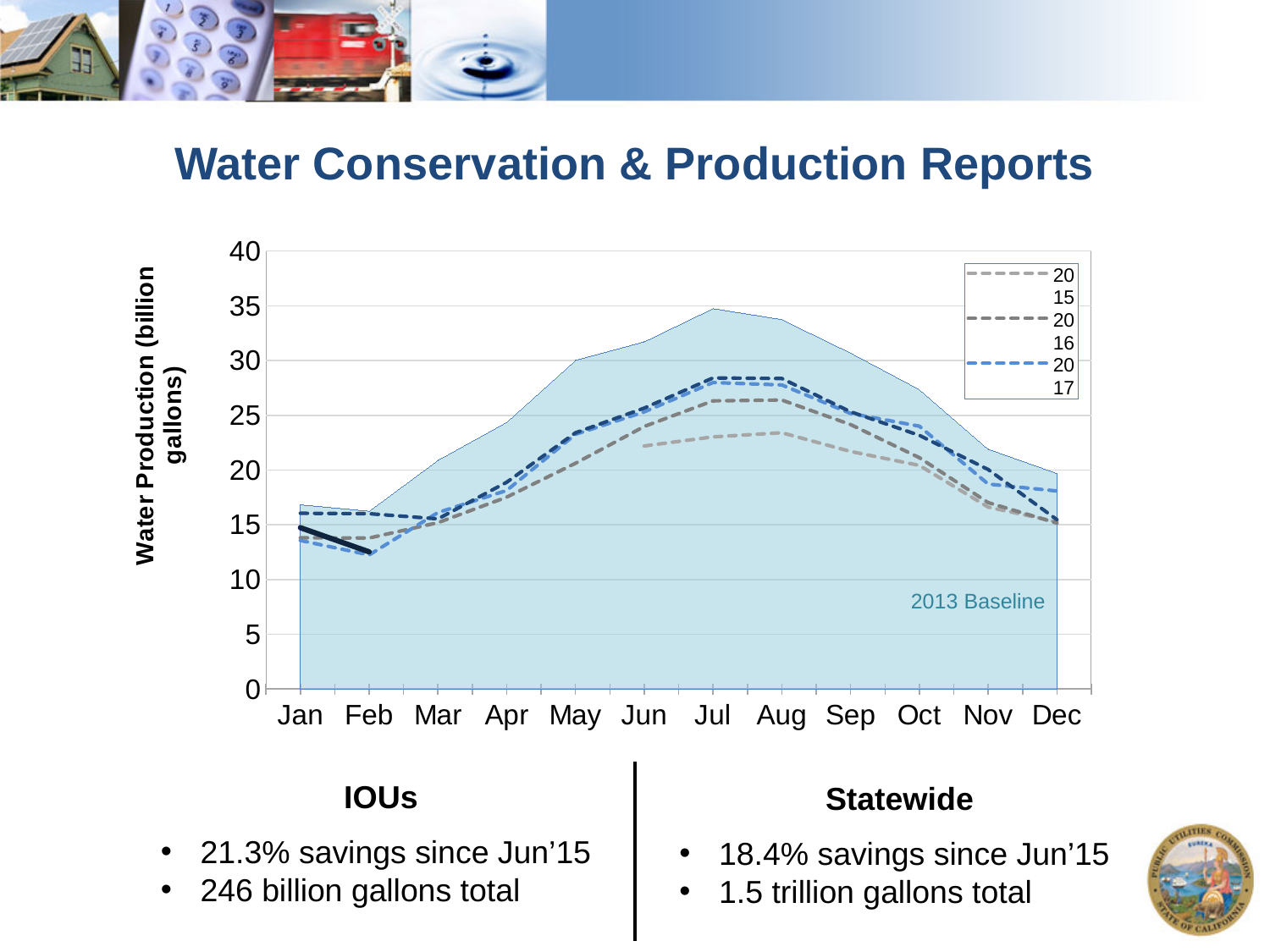
What label is printed inside the shaded area of the chart? 2013 Baseline Does the 2013 Baseline rise or fall from Jan to Jul? rise In which month does the 2013 Baseline reach its highest value? Jul What is the title of the chart's vertical axis? Water Production (billion gallons) What kind of chart is shown on the slide? combination area and line chart Is the 2017 value for Dec greater or less than 15? greater How many months are shown along the x axis of the chart? 12 How many series does the chart's legend list? 3 Is the 2013 Baseline value for Jul greater or less than 30? greater Is the 2017 value for Feb greater or less than 15? less In Aug, which is larger: the 2013 Baseline or the 2017 value? 2013 Baseline